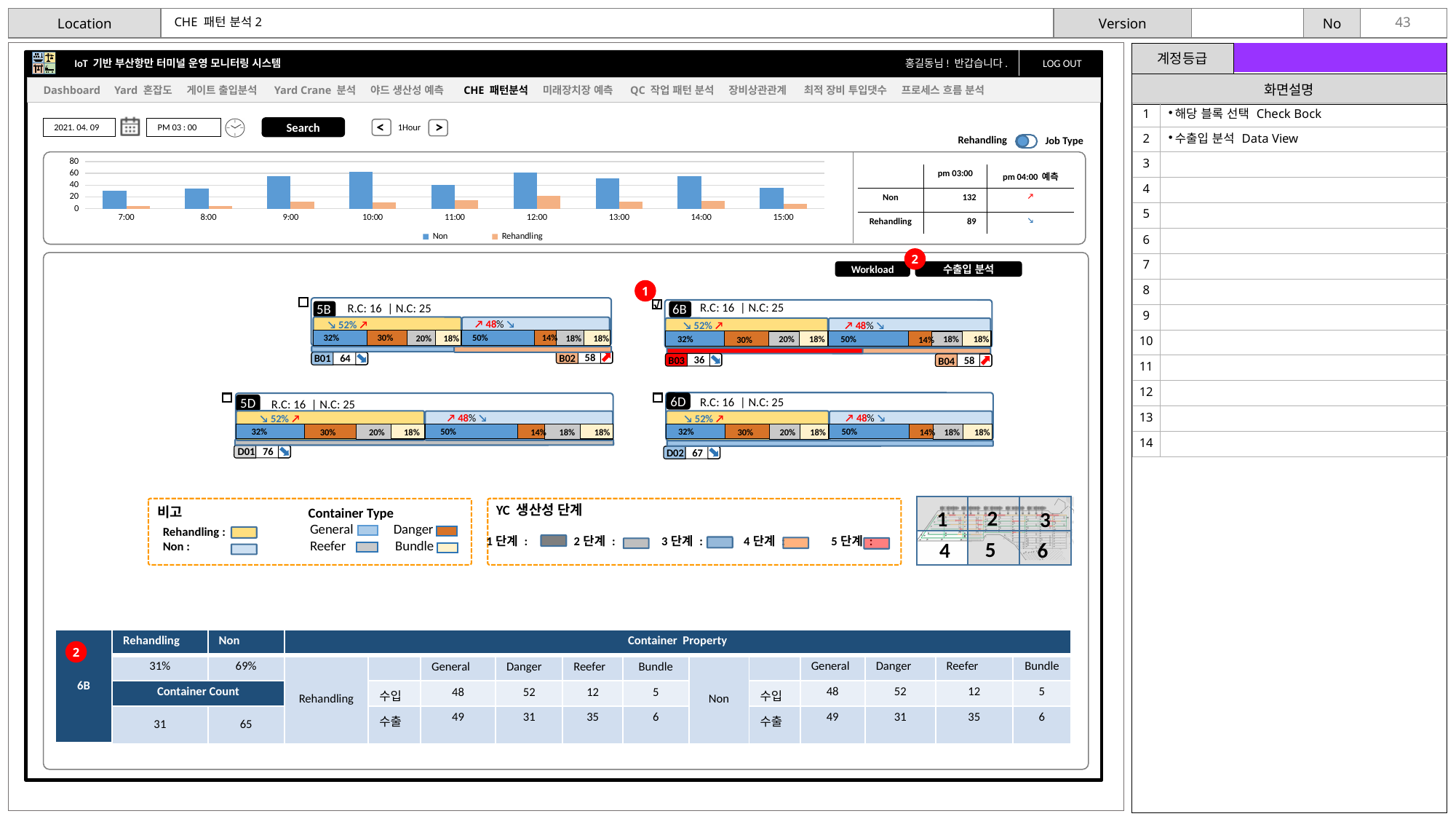
What kind of chart is the hourly chart at the top of the dashboard? bar chart In the top hourly bar chart, at which time is the Rehandling bar highest? 12:00 In the block 5B panel, what percentage is shown for the Rehandling (yellow) portion? 52% In the top hourly bar chart, which is larger, the Non bar at 10:00 or the Non bar at 7:00? 10:00 How many time points are shown on the x axis of the top hourly bar chart? 9 In the top hourly bar chart, is the Non value at 7:00 greater or less than 40? less In the top hourly bar chart, is the Rehandling value at 12:00 greater or less than 40? less In the top hourly bar chart, is the Non value at 10:00 greater or less than 40? greater In the top hourly bar chart, which is larger at 12:00, the Non bar or the Rehandling bar? Non In the top hourly bar chart, do the Non values rise or fall from 7:00 to 10:00? rise How many series does the legend of the top hourly bar chart list? 2 What are the two series named in the legend of the top hourly bar chart? Non and Rehandling